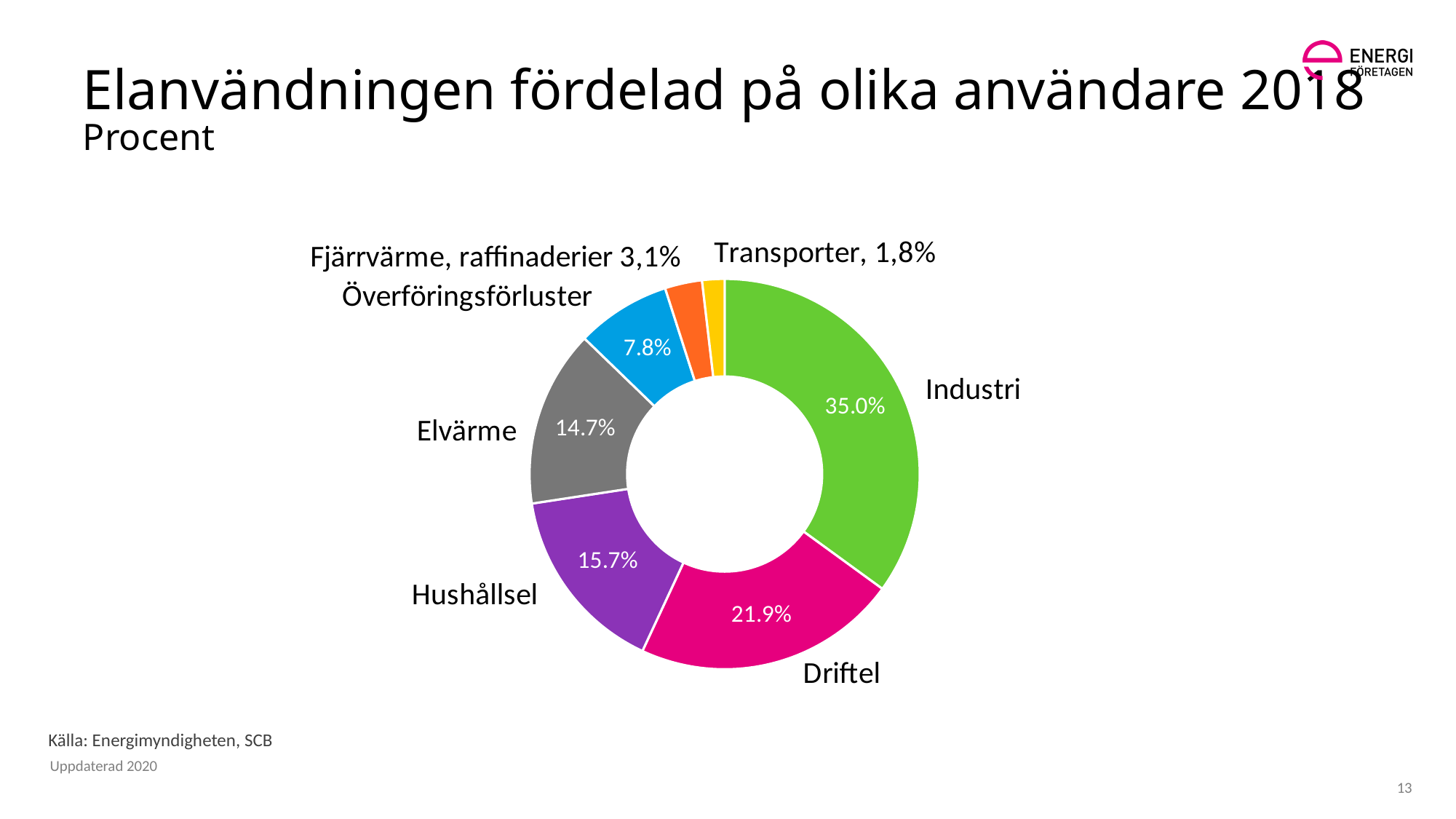
What is the difference between the shares of Industri and Driftel? 13.1% How many categories are shown in the chart? 7 Which is larger, the share for Hushållsel or the share for Elvärme? Hushållsel What is the value shown for Transporter? 1,8% What is the value shown for Driftel? 21.9% What share of electricity use does Industri account for? 35.0% Which category has the smallest share of the chart? Transporter What is the value shown for Överföringsförluster? 7.8% What is the value shown for Hushållsel? 15.7% What is the value shown for Elvärme? 14.7% What kind of chart is shown on the slide? Doughnut (pie) chart Which category has the largest share of the chart? Industri